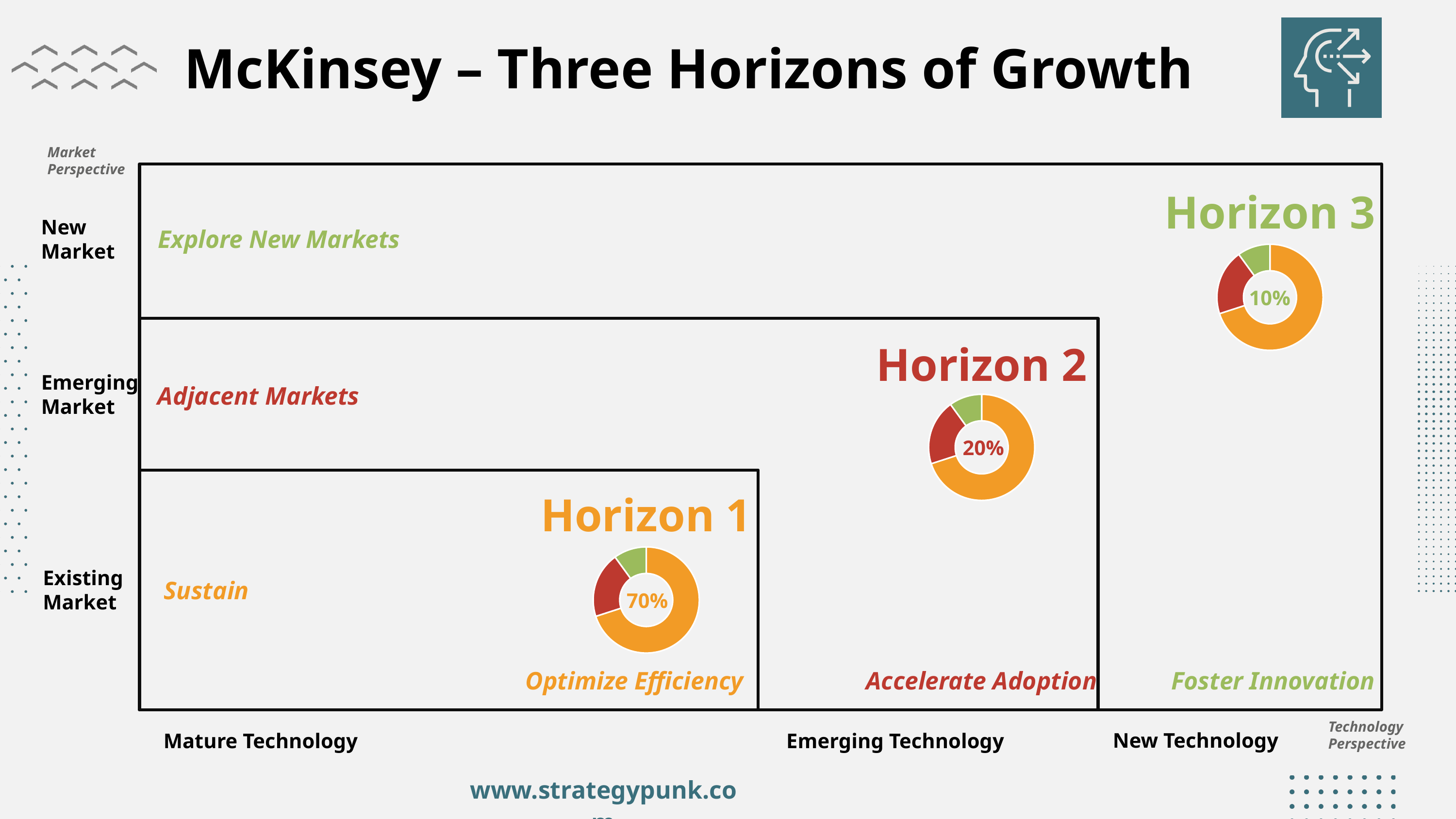
What percentage is shown in the centre of the Horizon 3 donut chart? 10% Which shows a larger percentage, the Horizon 2 donut chart or the Horizon 3 donut chart? Horizon 2 What percentage is shown in the centre of the Horizon 2 donut chart? 20% Which horizon's donut chart shows the lowest percentage? Horizon 3 What is the difference between the percentage shown for Horizon 2 and the percentage shown for Horizon 3? 10% What percentage is shown in the centre of the Horizon 1 donut chart? 70% What kind of chart is used to show the percentage for each horizon? Donut chart How many slices does each donut chart have? 3 How many donut charts are on the slide? 3 What colour is the Horizon 1 label text above its donut chart? Orange What is the difference between the percentage shown for Horizon 1 and the percentage shown for Horizon 2? 50% Which horizon's donut chart shows the highest percentage? Horizon 1